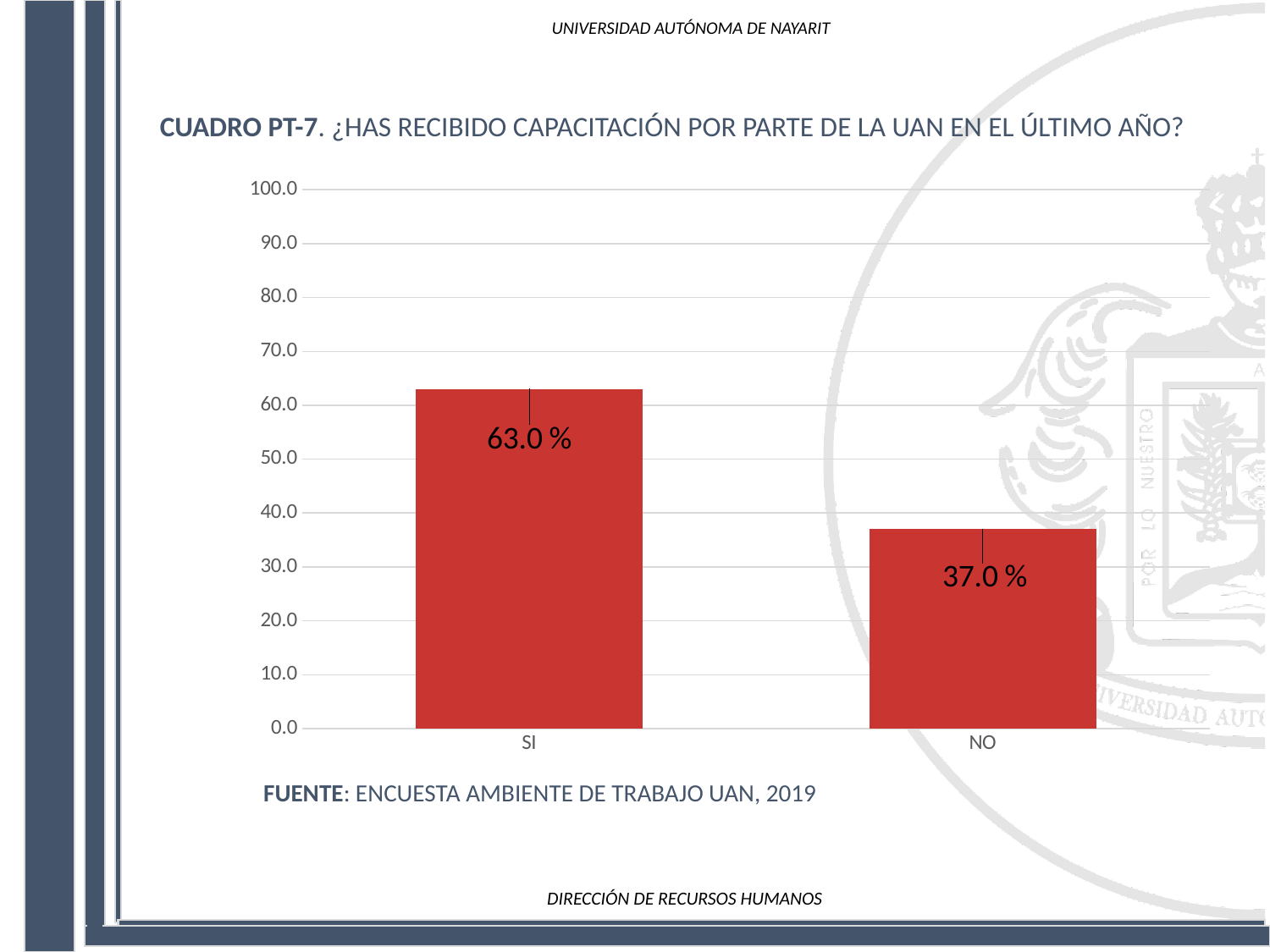
Which category has the highest value? SI What is the value for NO? 37.0 % Is the value for SI greater or less than 60.0? greater What is the value for SI? 63.0 % How many categories are shown on the x axis? 2 Which is larger, the value for SI or the value for NO? SI Is the value for NO greater or less than 40.0? less Which category has the lowest value? NO What is the source cited below the chart? ENCUESTA AMBIENTE DE TRABAJO UAN, 2019 What is the difference between the values for SI and NO? 26.0 % What is the highest value shown on the y axis? 100.0 What kind of chart is shown on the slide? bar chart